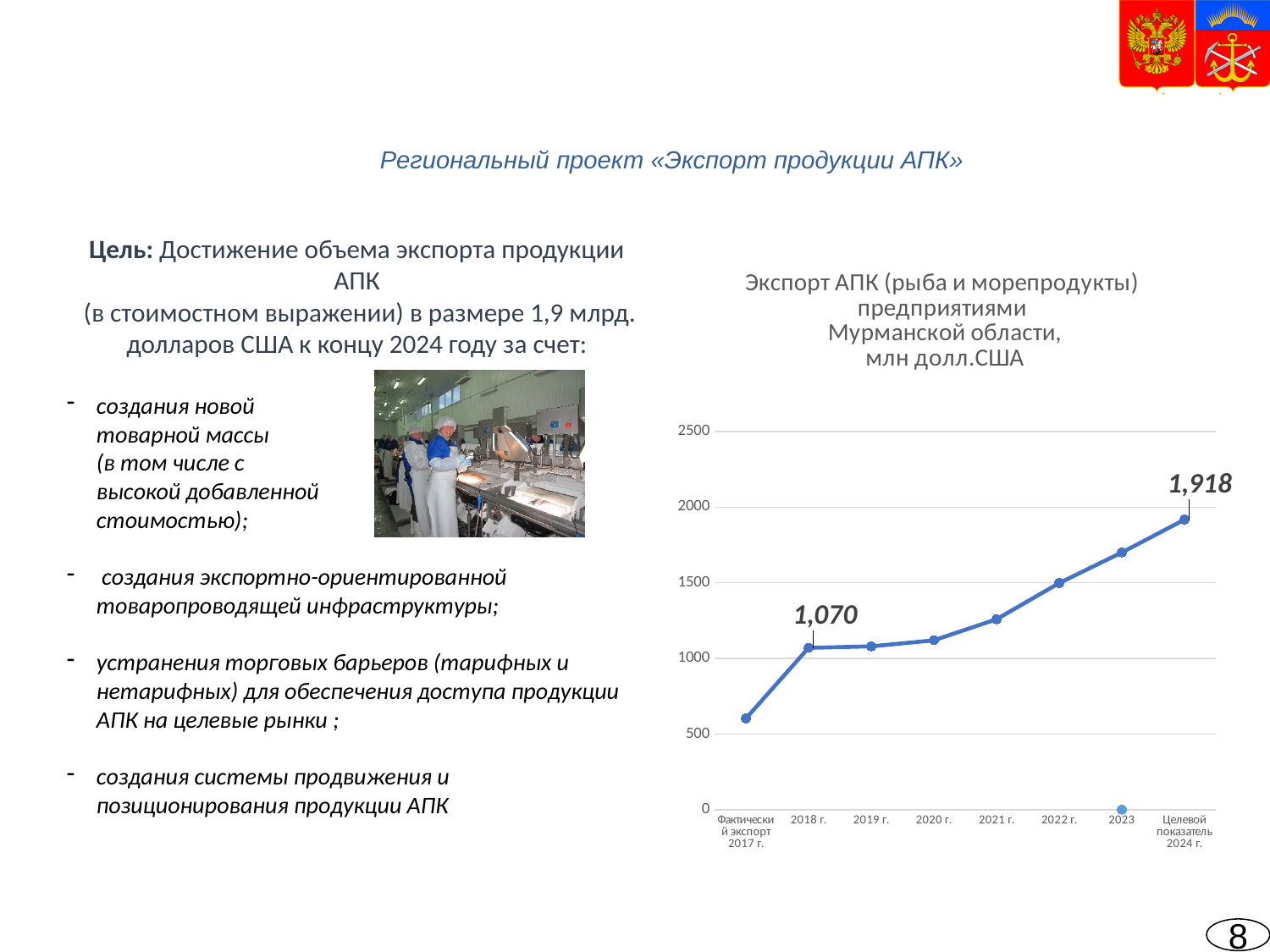
How many points are plotted along the x axis of the chart? 8 Is the value for 2021 г. greater or less than 1000? greater Which is larger, the value for 2018 г. or the value for Целевой показатель 2024 г.? Целевой показатель 2024 г. What kind of chart is shown on the slide? line chart What is the value for 2018 г. in the chart? 1,070 Do the values rise or fall from Фактический экспорт 2017 г. to Целевой показатель 2024 г.? rise Is the value for 2023 greater or less than 1500? greater Is the value for Фактический экспорт 2017 г. greater or less than 1000? less What is the difference between the value for Целевой показатель 2024 г. and the value for 2018 г.? 848 In what units are the values of the chart expressed, according to its title? млн долл.США What is the value for Целевой показатель 2024 г. in the chart? 1,918